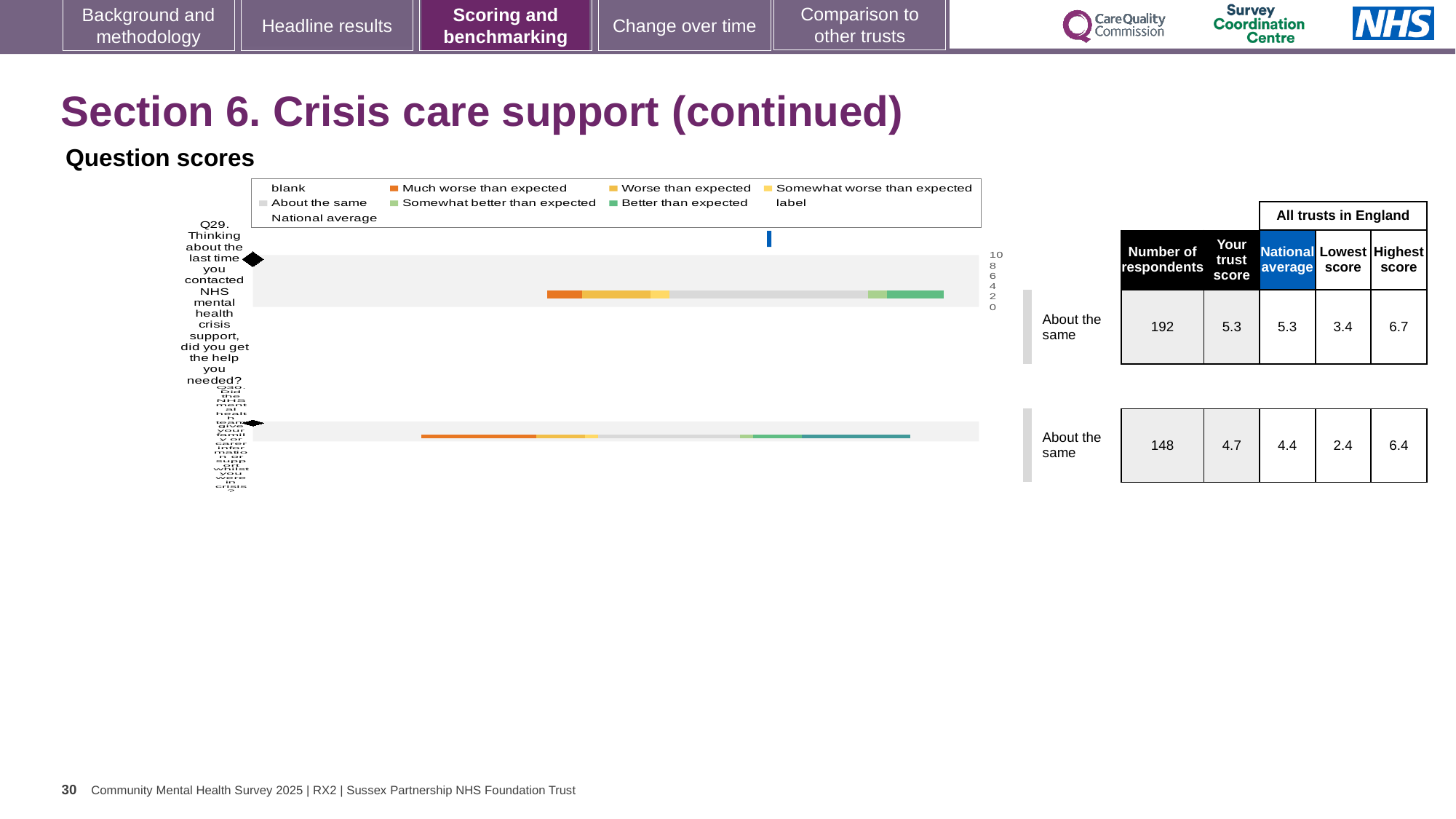
How many respondents answered Q29? 192 What kind of chart is used to show the question scores on this slide? bar chart What is the lowest score across all trusts in England for Q30? 2.4 What is the highest value shown on the score axis of the question scores chart? 10 Which question has more respondents, Q29 or Q30? Q29 What is the difference between the highest score and the lowest score for Q29? 3.3 What is the national average for Q30 in the question scores table? 4.4 How many questions (rows) are plotted in the question scores chart? 2 What is the trust score for Q29 in the question scores table? 5.3 How many entries does the legend of the question scores chart list? 9 In the question scores chart, which legend entry is shown in orange? Much worse than expected What benchmark category is given for Q30 (the text next to its bar)? About the same